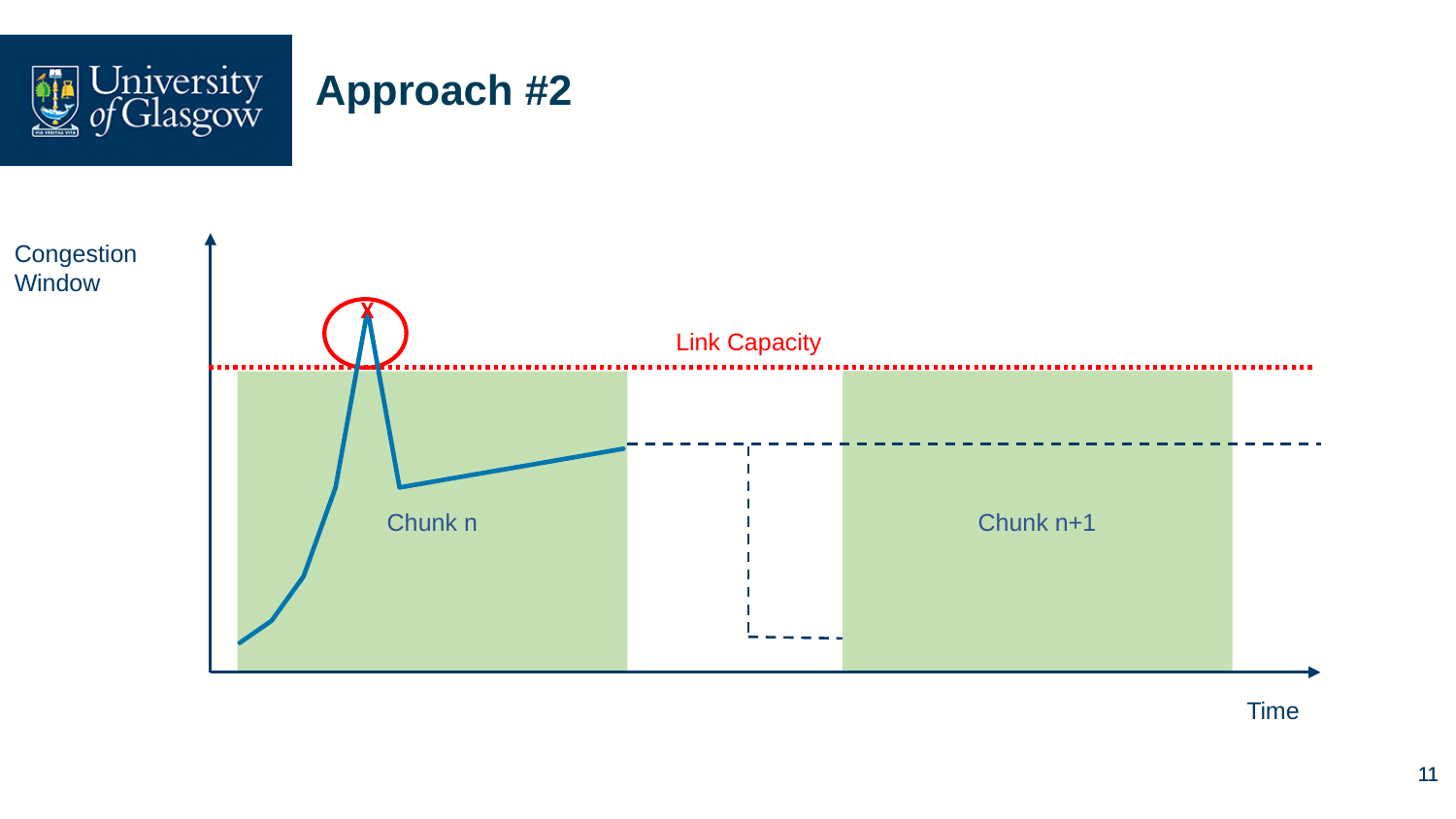
Is the peak of the congestion window at the red X above or below the Link Capacity line? above What does the red dotted horizontal line represent? Link Capacity Does the congestion window rise or fall immediately after the red X marker? fall What is the label of the vertical axis? Congestion Window How many shaded chunk regions are shown on the chart? 2 What kind of chart is shown on the slide? line chart Does the congestion window rise or fall at the start of Chunk n, before the red X? rise